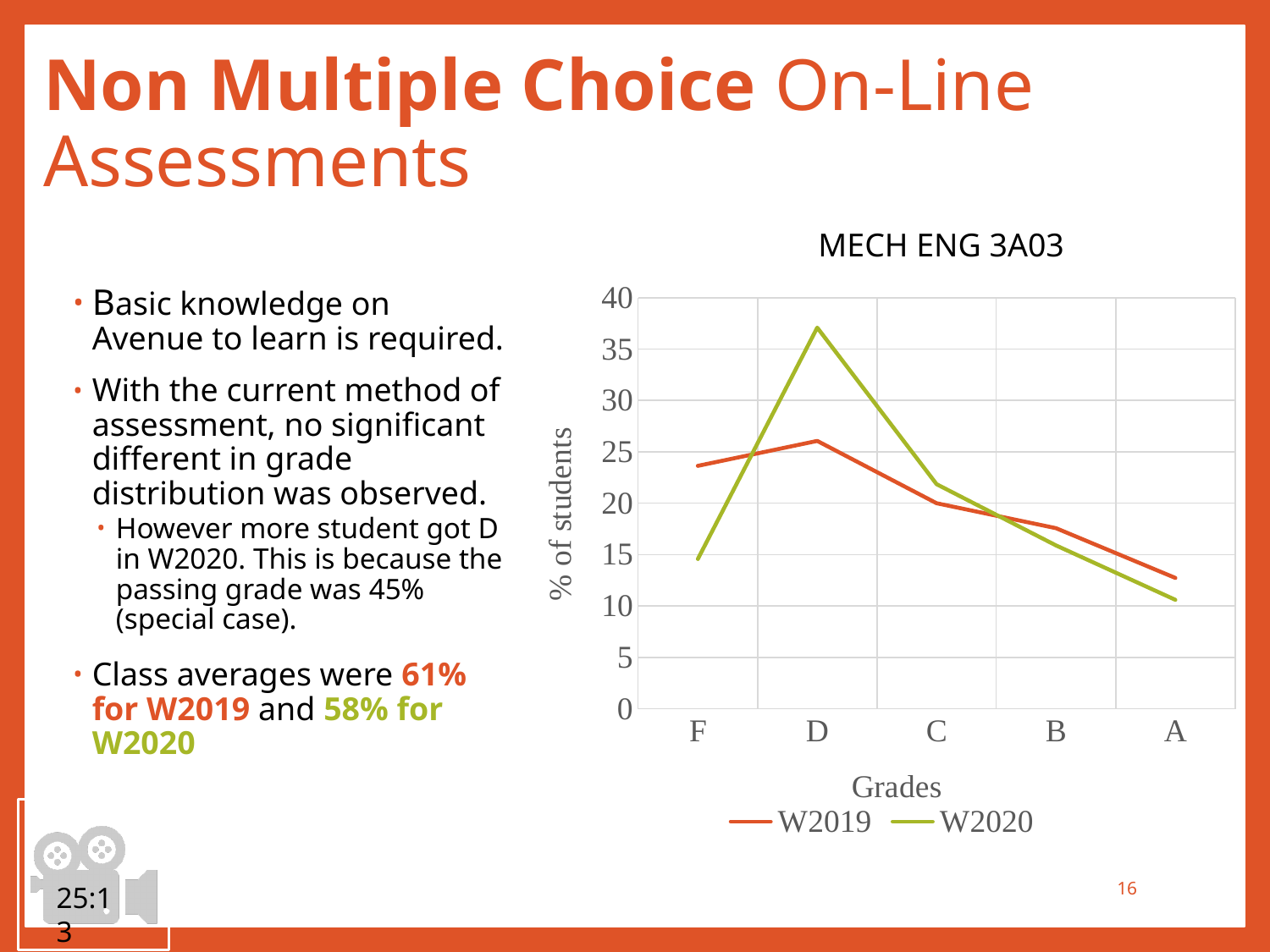
At grade F, which series has the higher percentage of students, W2019 or W2020? W2019 Is the W2020 value for grade D greater or less than 35? greater What is the label of the y axis of the chart? % of students What kind of chart is shown on the slide? line chart Is the W2019 value for grade A greater or less than 15? less For which grade is the W2019 percentage of students lowest? A How many grade categories are shown on the x axis of the chart? 5 How many series does the chart's legend list? 2 For which grade is the W2020 percentage of students lowest? A What is the title of the chart? MECH ENG 3A03 At grade D, which series has the higher percentage of students, W2019 or W2020? W2020 For which grade is the W2020 percentage of students highest? D